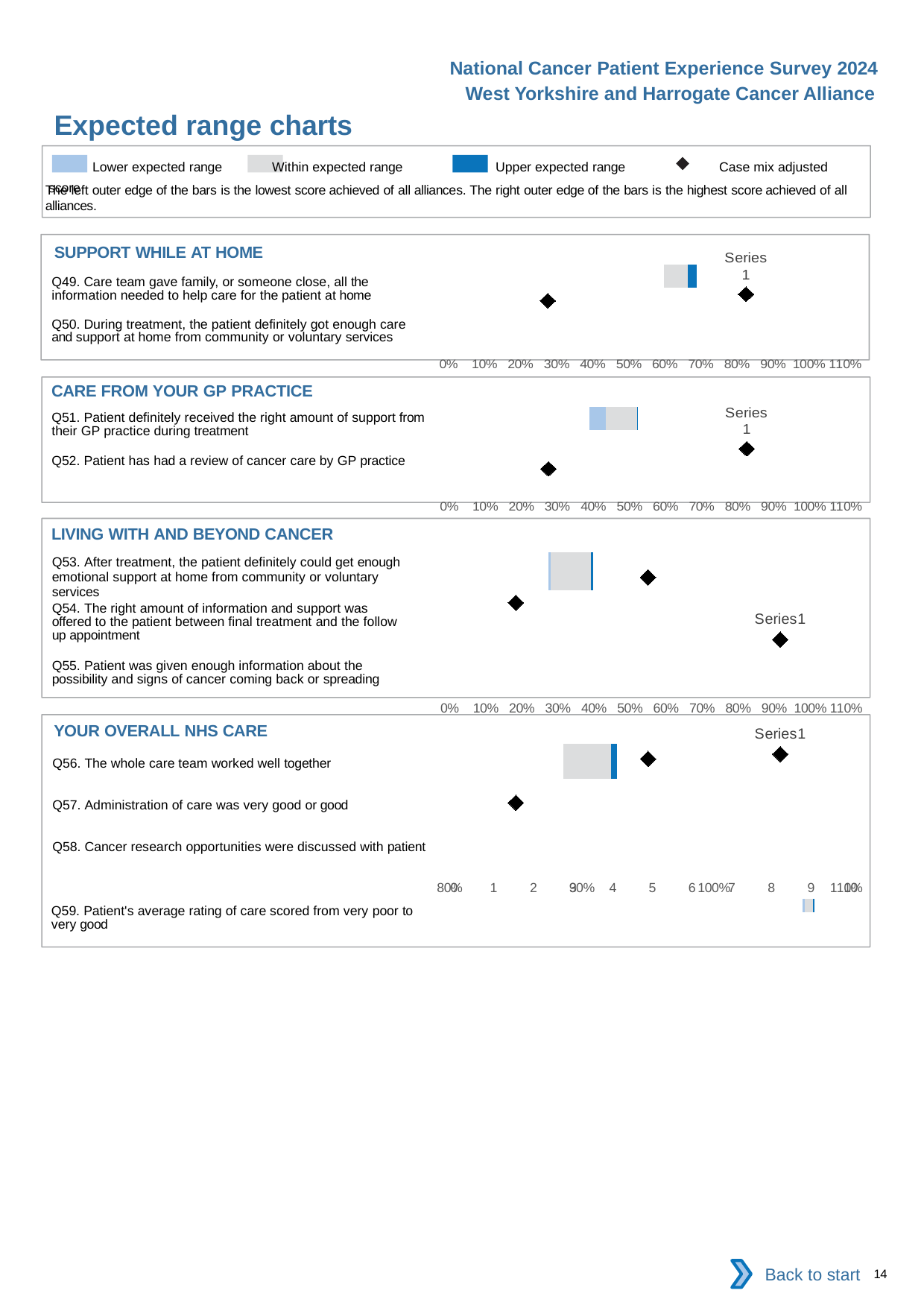
What kind of chart is used in the SUPPORT WHILE AT HOME section? bar chart How many questions are listed in the SUPPORT WHILE AT HOME chart? 2 In the YOUR OVERALL NHS CARE chart, is the shaded expected range bar positioned greater or less than 20% on the axis? greater How many entries does the legend at the top of the slide list? 4 What is the title of the slide containing the charts? Expected range charts What is the highest percentage tick shown on the x axis of the CARE FROM YOUR GP PRACTICE chart? 110% How many questions are listed in the LIVING WITH AND BEYOND CANCER chart? 3 In the CARE FROM YOUR GP PRACTICE chart, is the shaded expected range bar positioned greater or less than 30% on the axis? greater In the SUPPORT WHILE AT HOME chart, is the shaded expected range bar positioned greater or less than 50% on the axis? greater How many questions are listed in the YOUR OVERALL NHS CARE chart? 4